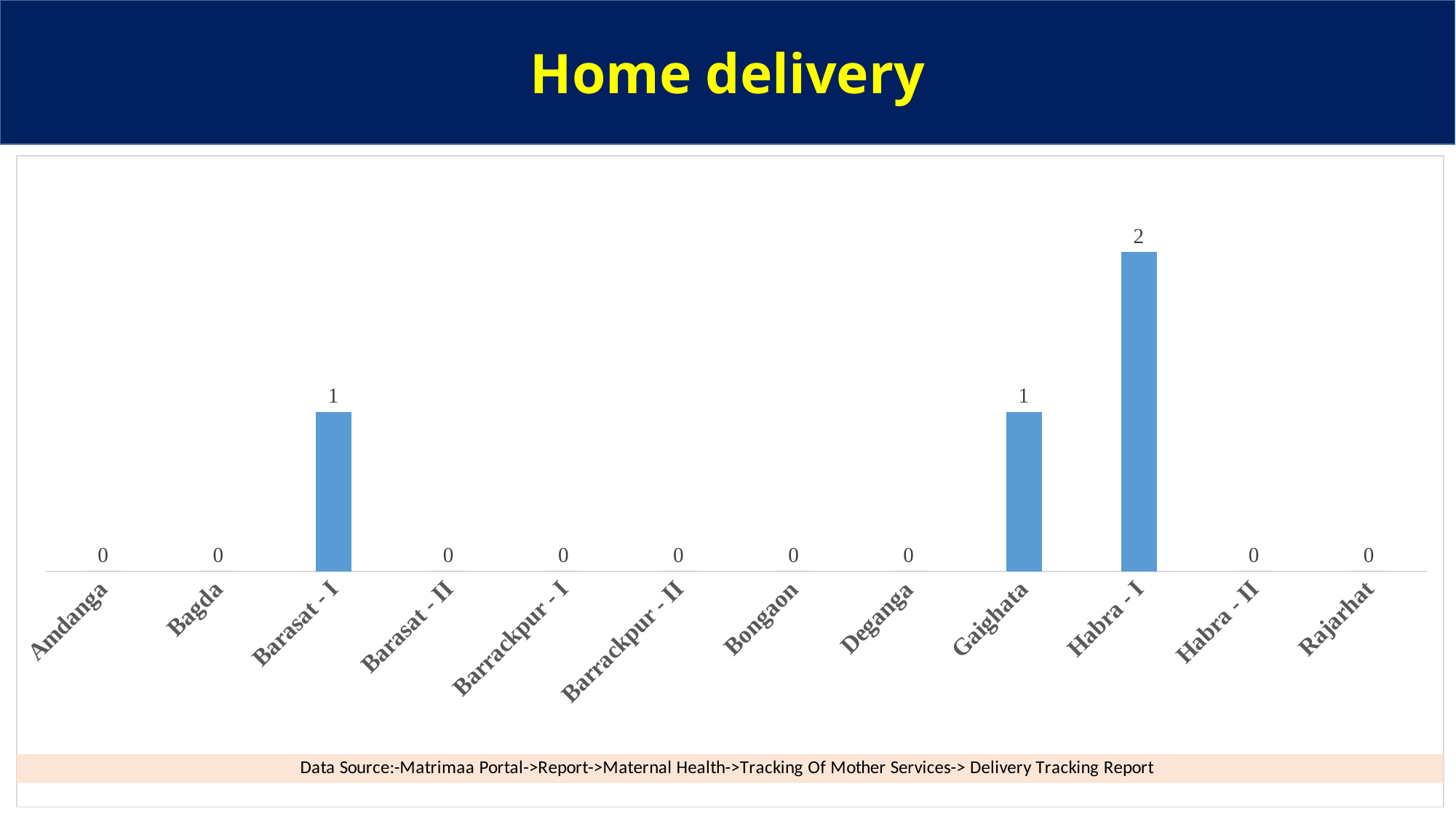
What is the difference between the values for Habra - I and Gaighata? 1 How many categories have a value of 0? 9 What is the value for Barasat - I? 1 What is the title of the slide? Home delivery What kind of chart is shown on the slide? bar chart Which is larger, the value for Habra - I or the value for Barasat - I? Habra - I How many categories are shown on the x axis? 12 What is the value for Gaighata? 1 What is the value for Deganga? 0 Which category has the highest value? Habra - I What is the value for Habra - I? 2 What colour are the bars in the chart? blue